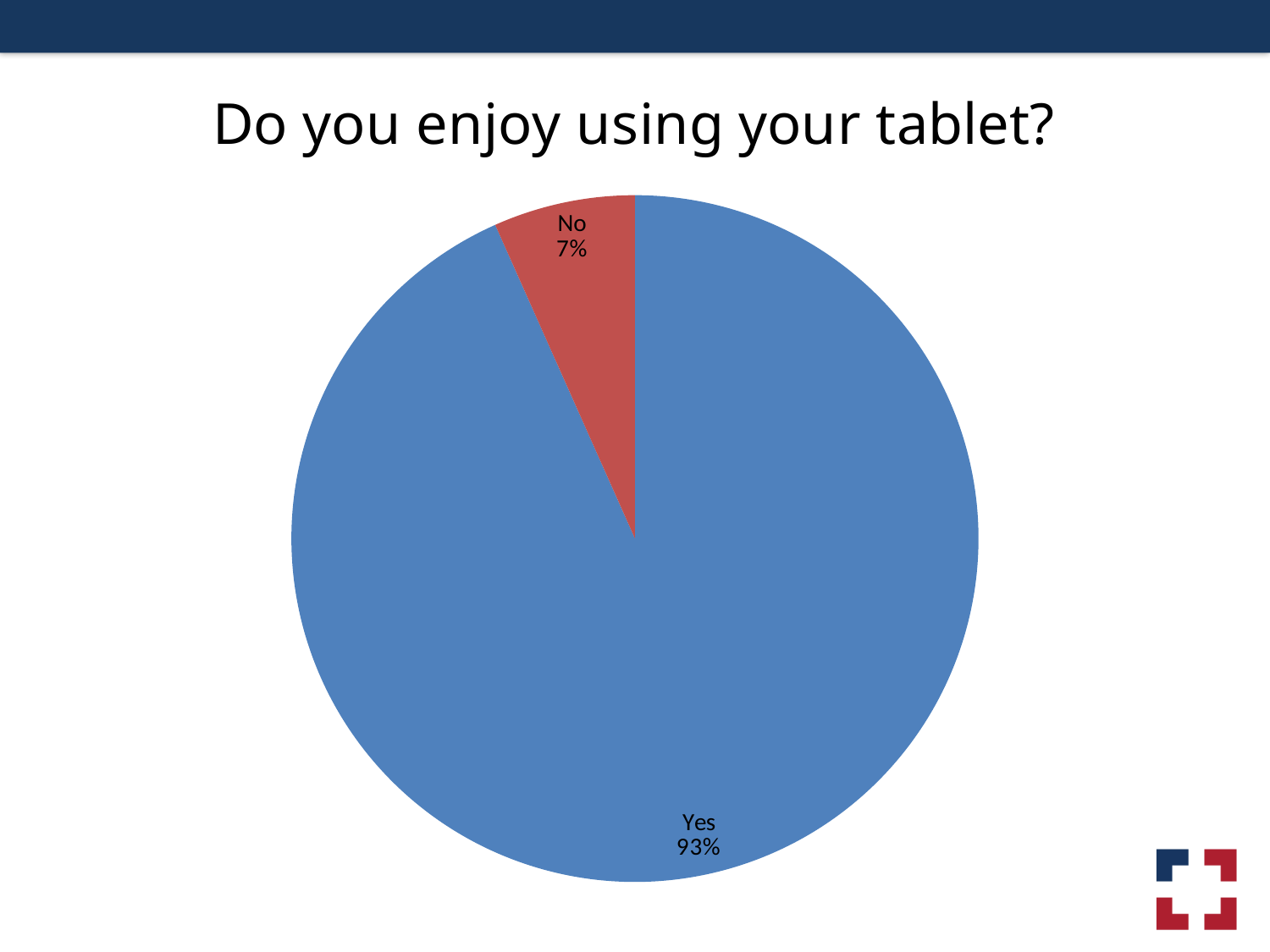
What kind of chart is shown on the slide? pie chart What colour is the Yes slice? blue How many slices does the pie chart have? 2 What is the difference in percentage points between the Yes and No slices? 86 Which slice is larger, Yes or No? Yes What share of the pie does the No slice represent? 7% Which response has the smallest share of the pie? No What percentage of respondents answered No? 7% Which response has the largest share of the pie? Yes What is the title of the chart? Do you enjoy using your tablet? What percentage of respondents answered Yes? 93%